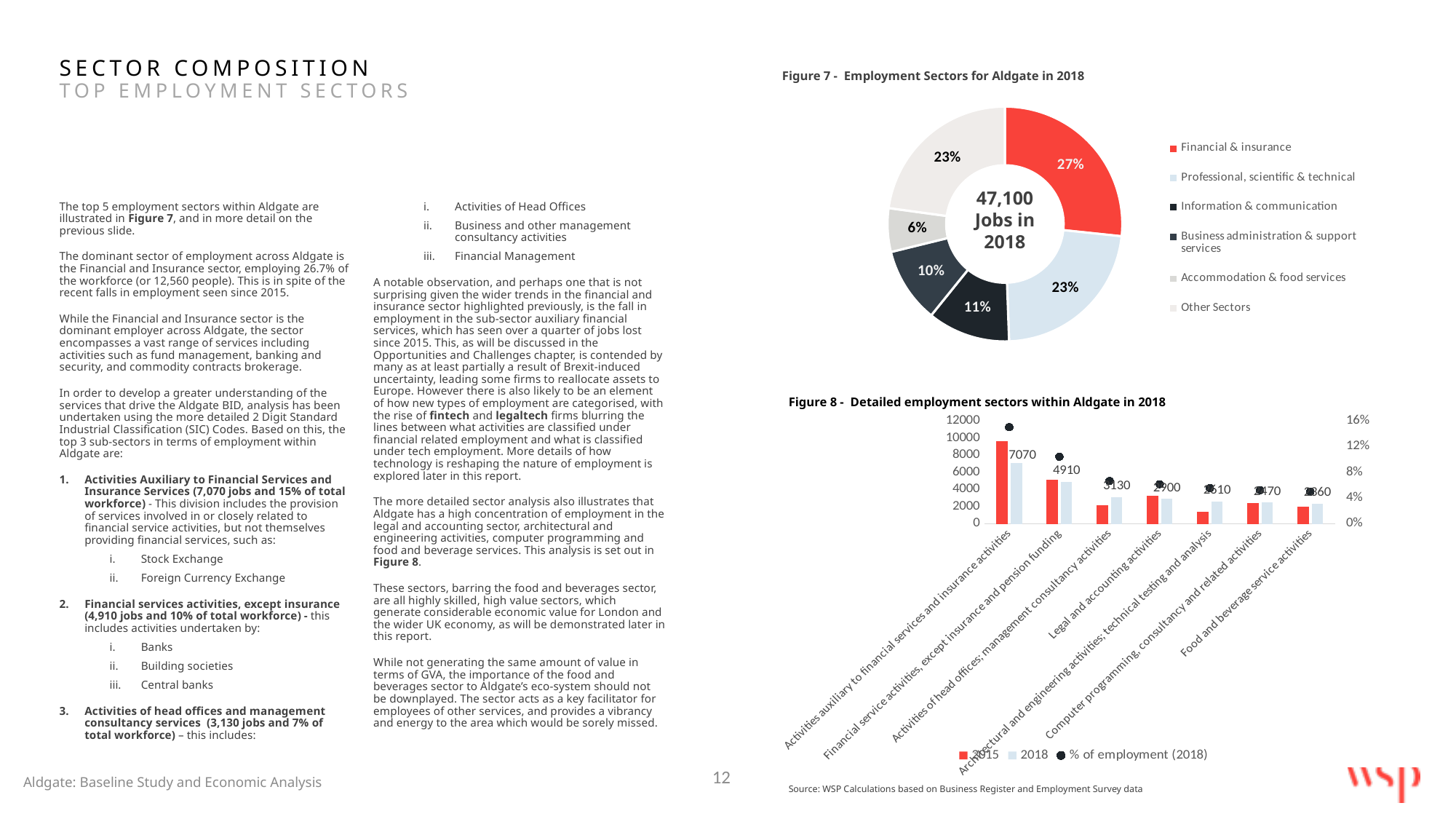
How many series does the legend of Figure 8 list? 3 In Figure 8, is the 2015 value for Activities auxiliary to financial services and insurance activities greater or less than 8000? greater In Figure 7, which sector has the smallest share? Accommodation & food services In Figure 7, what share of employment is Financial & insurance? 27% In Figure 8, what is the 2018 value for Legal and accounting activities? 2900 What total number of jobs is shown in the centre of Figure 7? 47,100 How many sectors does the legend of Figure 7 list? 6 What kind of chart is Figure 7 - Employment Sectors for Aldgate in 2018? doughnut chart In Figure 8, do the 2018 values rise or fall moving from left to right along the x axis? fall In Figure 7, which sector has the largest share? Financial & insurance In Figure 8, what is the difference between the 2018 values for Activities auxiliary to financial services and insurance activities and Financial service activities, except insurance and pension funding? 2160 In Figure 7, what percentage is shown for Accommodation & food services? 6%